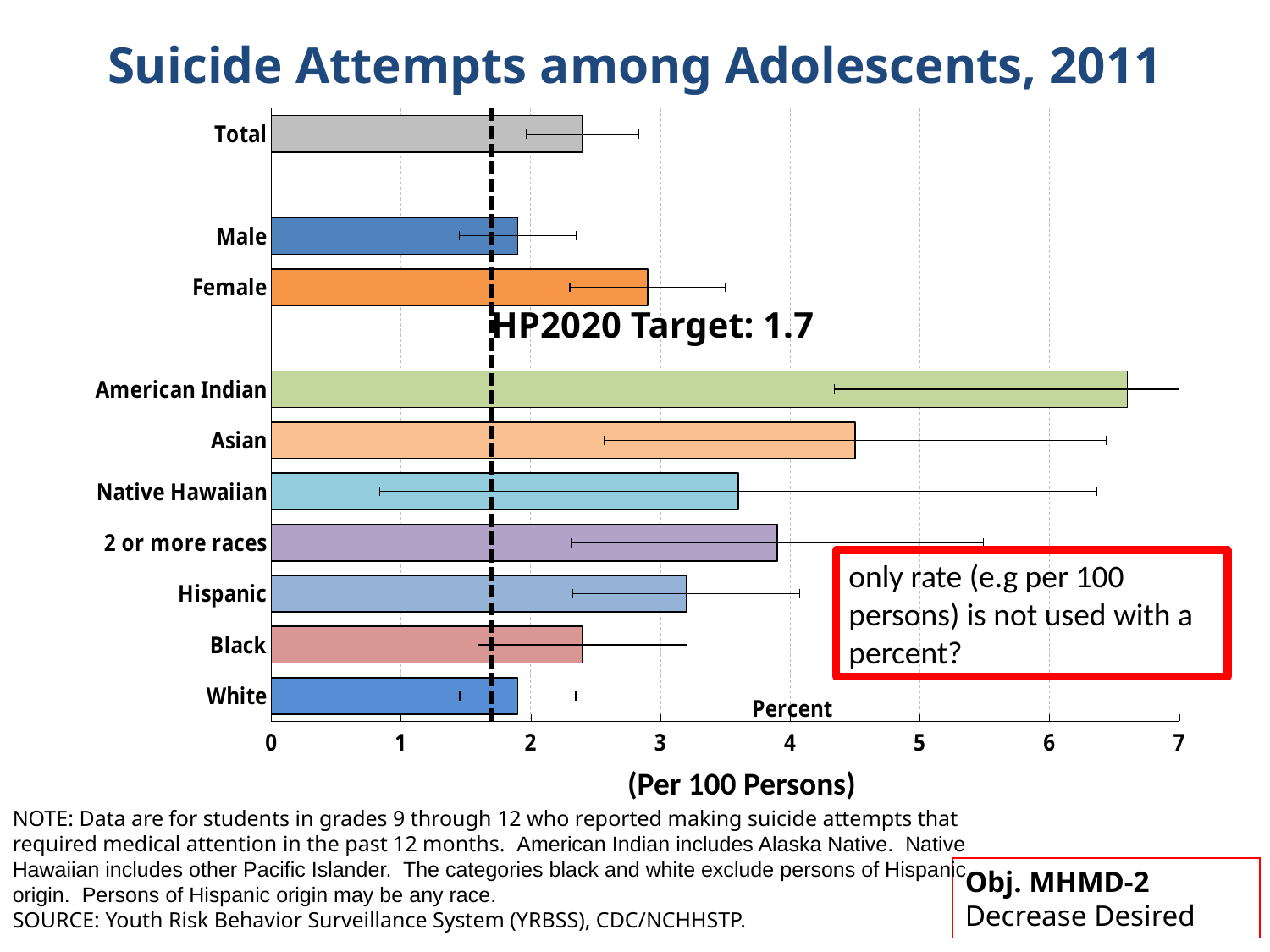
What kind of chart is shown on the slide? bar chart What is the HP2020 Target value shown on the chart? 1.7 Which has the larger value, Male or Female? Female Is the value for Black greater or less than 3? less Is the value for American Indian greater or less than 6? greater Which has the larger value, Asian or Native Hawaiian? Asian Is the value for Asian greater or less than 4? greater Which group has the highest rate of suicide attempts in the chart? American Indian What is the title of the chart? Suicide Attempts among Adolescents, 2011 How many groups (bars) are plotted in the chart? 10